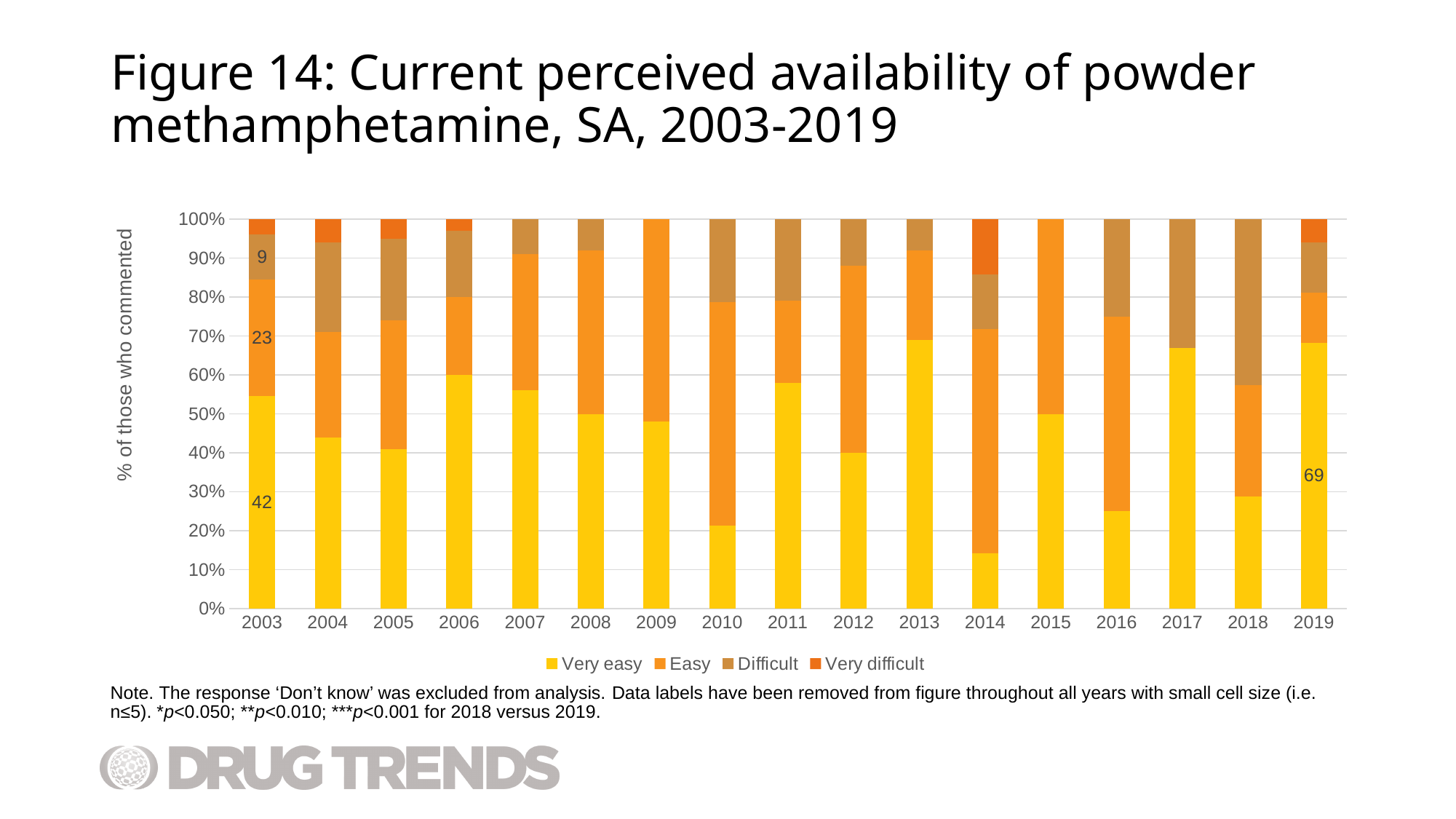
What data label is printed on the 'Very easy' segment for 2019? 69 Is the 'Very easy' share for 2013 greater or less than 60%? greater How many series does the chart's legend list? 4 What is the title of the y axis? % of those who commented What data label is printed on the 'Difficult' segment for 2003? 9 Is the 'Very easy' share for 2014 greater or less than 20%? less What kind of chart is shown on the slide? Stacked bar chart How many years are shown along the x axis of the chart? 17 Which year has the smallest 'Very easy' share? 2014 Which year has the larger 'Very easy' share, 2014 or 2015? 2015 What data label is printed on the 'Easy' segment for 2003? 23 What data label is printed on the 'Very easy' segment for 2003? 42